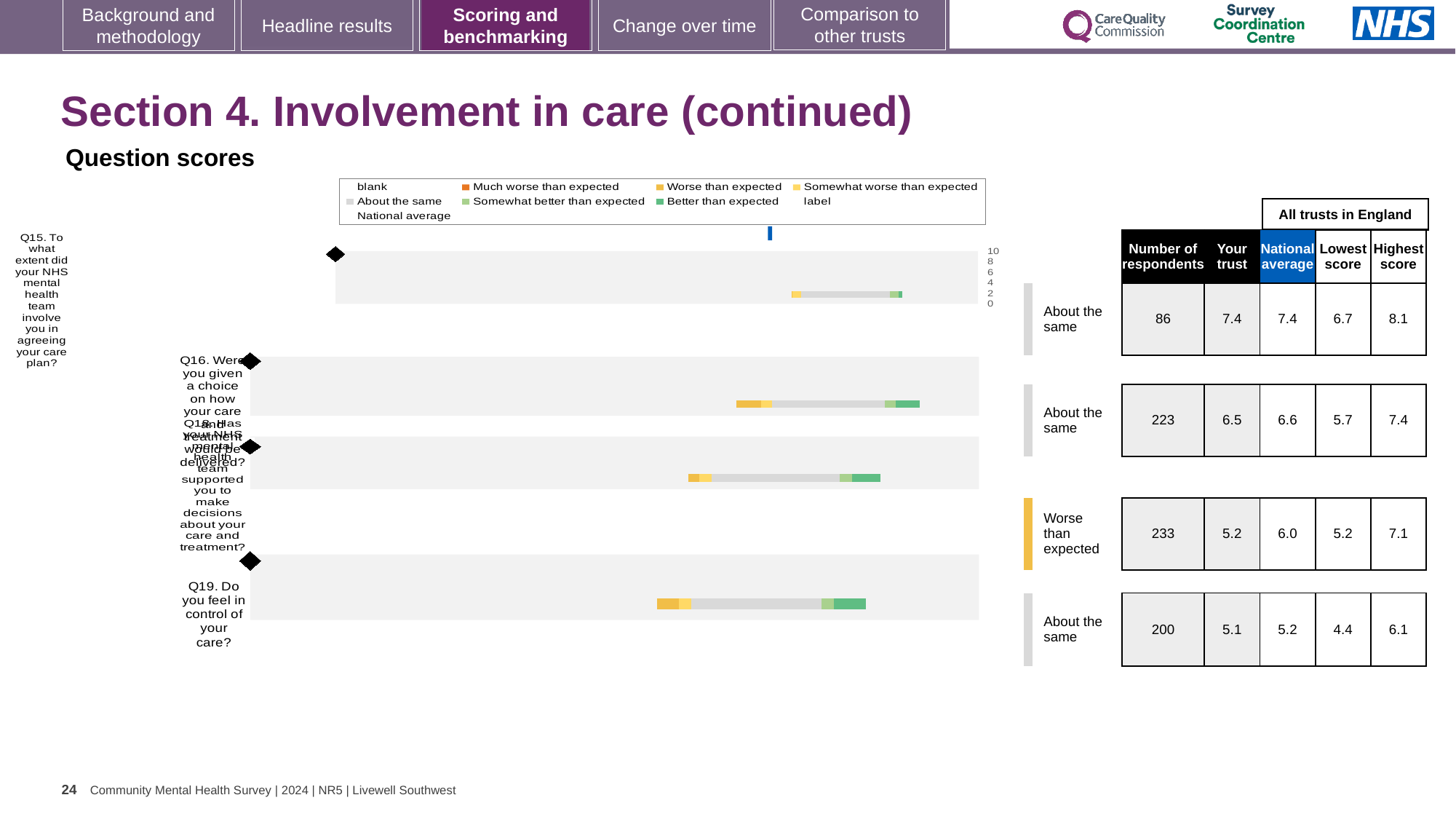
Which question has the lowest 'Your trust' score? Q19 How many questions are plotted in the question scores chart? 4 What is the highest score among all trusts in England for Q16? 7.4 What is the lowest score among all trusts in England for Q19? 4.4 What is the 'Your trust' score for Q15 (involvement in agreeing your care plan)? 7.4 What is the national average score for Q19 (feeling in control of your care)? 5.2 What kind of chart is used to show the question scores on this slide? bar chart What benchmark category is shown for Q18? Worse than expected For Q16, which is larger: the 'Your trust' score or the national average? National average For Q18, how much higher is the national average than the 'Your trust' score? 0.8 Which question has the highest 'Your trust' score? Q15 How many respondents answered Q18 (supported to make decisions about care and treatment)? 233